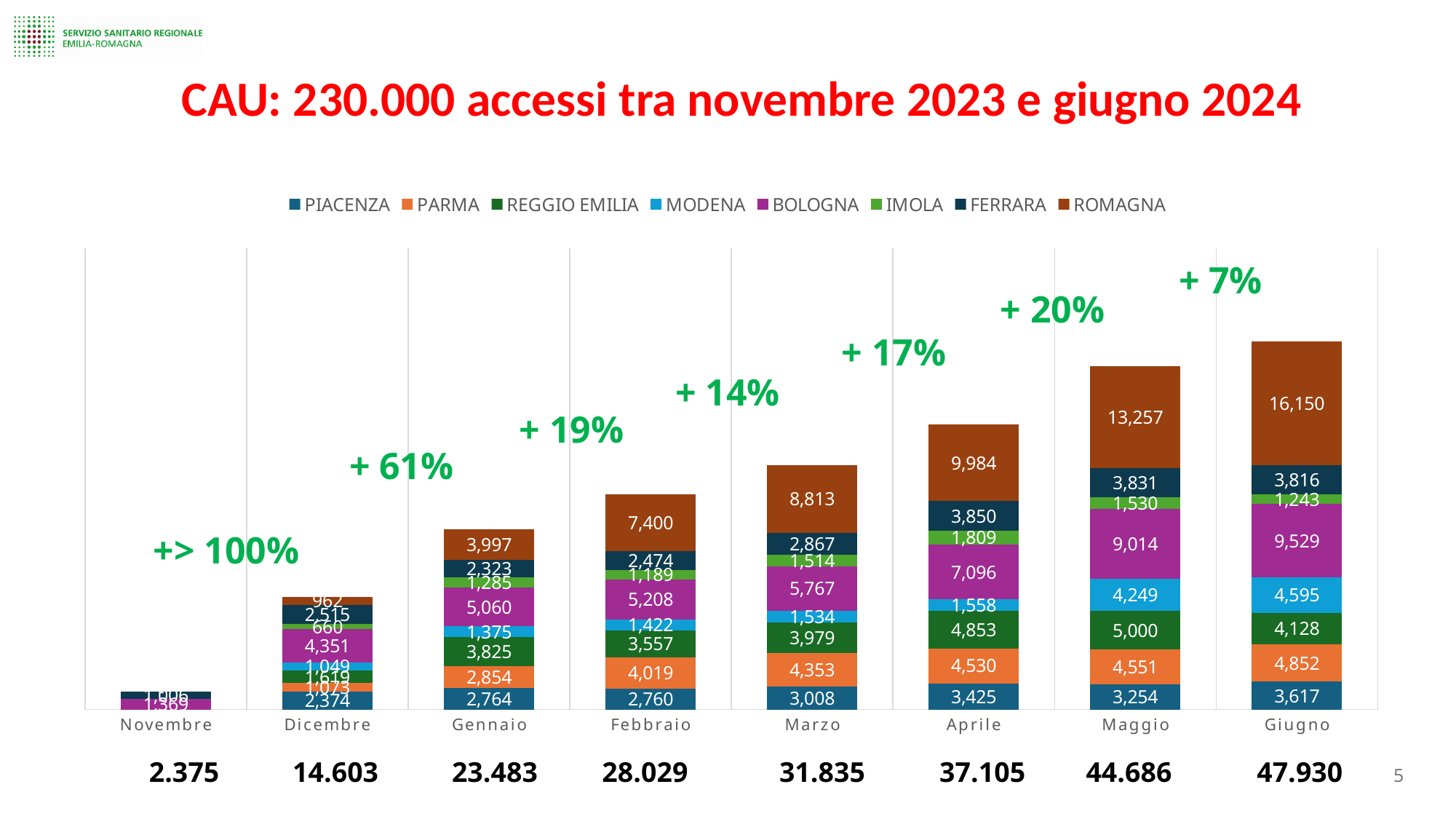
Which month has the lowest total? Novembre Which is larger, the PARMA value in Marzo or the REGGIO EMILIA value in Marzo? PARMA (4,353) How many months are shown along the x axis? 8 What type of chart is shown on the slide? Stacked bar chart What is the value for BOLOGNA in Maggio? 9,014 What is the value for ROMAGNA in Giugno? 16,150 What is the difference between the ROMAGNA values in Giugno and Maggio? 2,893 What is the total shown for the Aprile bar? 37.105 What percentage increase is shown above the Maggio bar? + 20% How many series does the legend list? 8 Which month has the highest total? Giugno What is the value for MODENA in Febbraio? 1,422